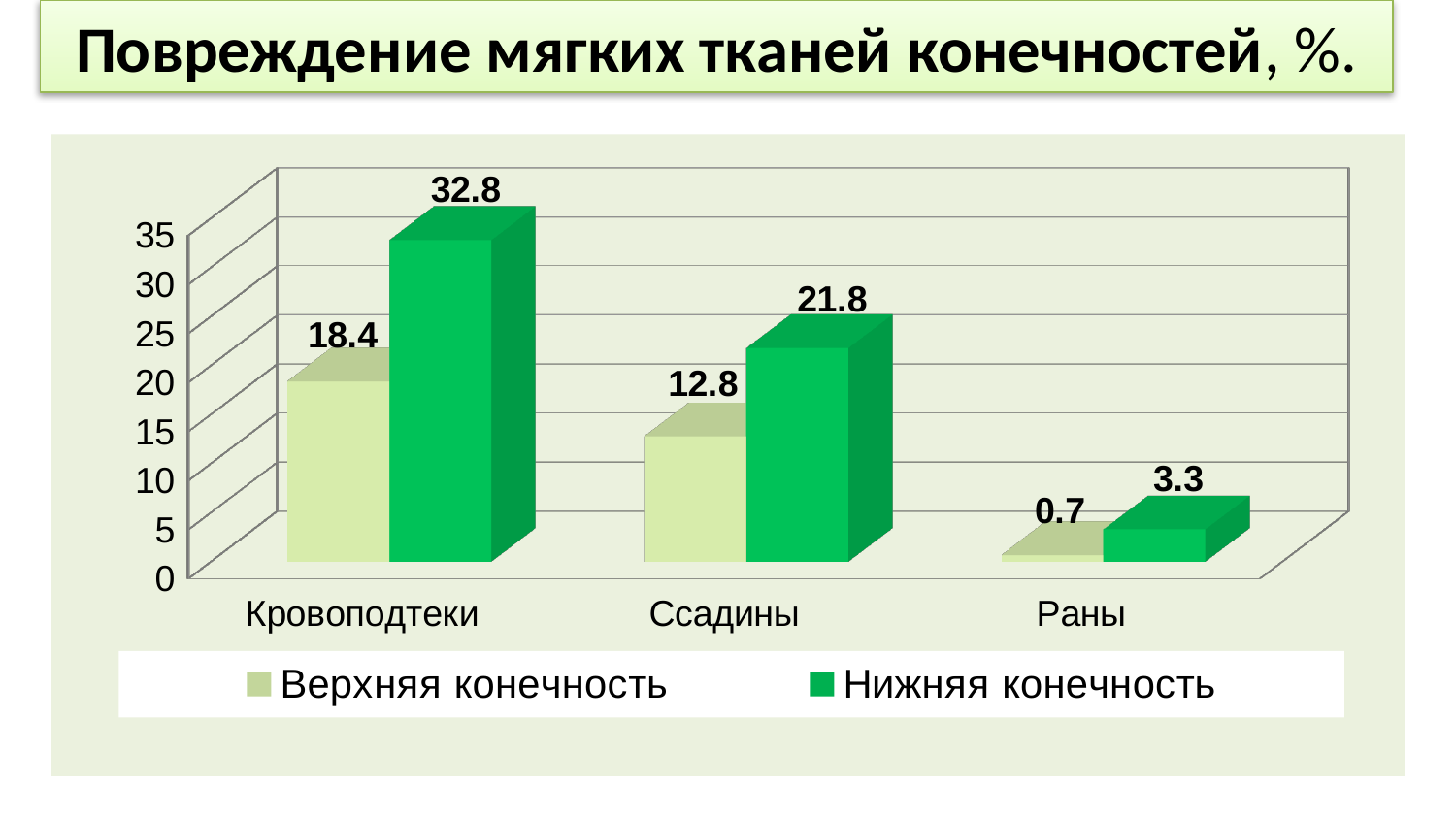
Which category has the highest value for Нижняя конечность? Кровоподтеки What is the difference between the Нижняя конечность and Верхняя конечность values for Кровоподтеки? 14.4 How many series does the legend list? 2 What is the value for Верхняя конечность in the Раны category? 0.7 Which is larger for Ссадины: Верхняя конечность or Нижняя конечность? Нижняя конечность What is the value for Верхняя конечность in the Кровоподтеки category? 18.4 What is the difference between the Нижняя конечность and Верхняя конечность values for Раны? 2.6 What kind of chart is shown on the slide? Bar chart How many categories are shown on the x axis? 3 What is the title of the chart? Повреждение мягких тканей конечностей, %. Which category has the lowest value for Верхняя конечность? Раны What is the value for Нижняя конечность in the Ссадины category? 21.8